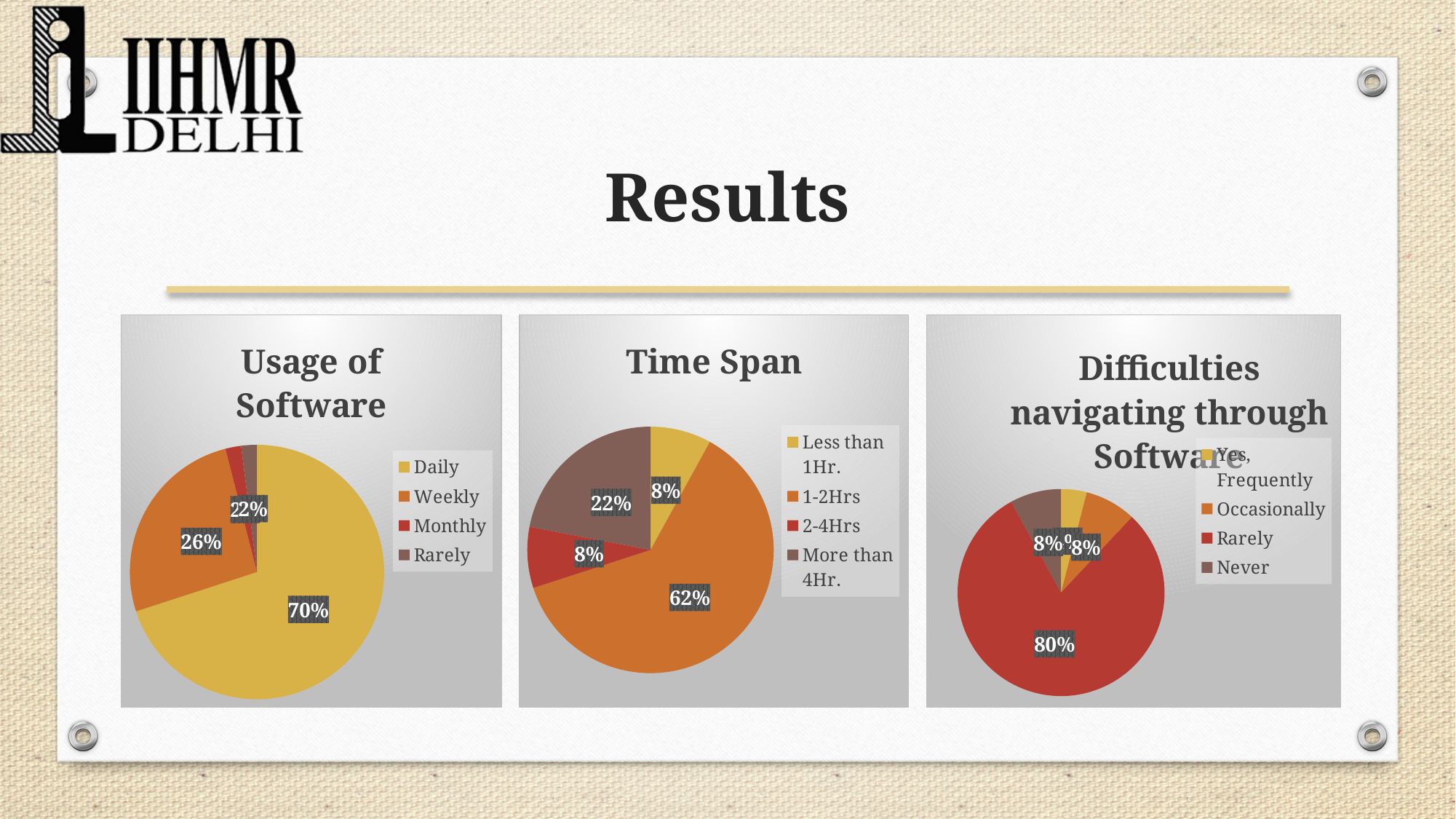
What type of chart is used for 'Time Span'? Pie chart In the 'Usage of Software' chart, what is the share for Weekly? 26% In the 'Time Span' chart, which category has the largest share? 1-2Hrs In the 'Time Span' chart, what share is shown for 1-2Hrs? 62% In the 'Time Span' chart, how many categories does the legend list? 4 In the 'Usage of Software' chart, what percentage of respondents use the software daily? 70% In the 'Difficulties navigating through Software' chart, which is larger, Rarely or Occasionally? Rarely In the 'Difficulties navigating through Software' chart, what share is shown for Rarely? 80% In the 'Difficulties navigating through Software' chart, what is the difference between the Rarely and Never shares? 72% In the 'Time Span' chart, what share is shown for More than 4Hr.? 22% In the 'Usage of Software' chart, what is the difference between the Daily and Weekly shares? 44% In the 'Usage of Software' chart, which category has the largest slice? Daily